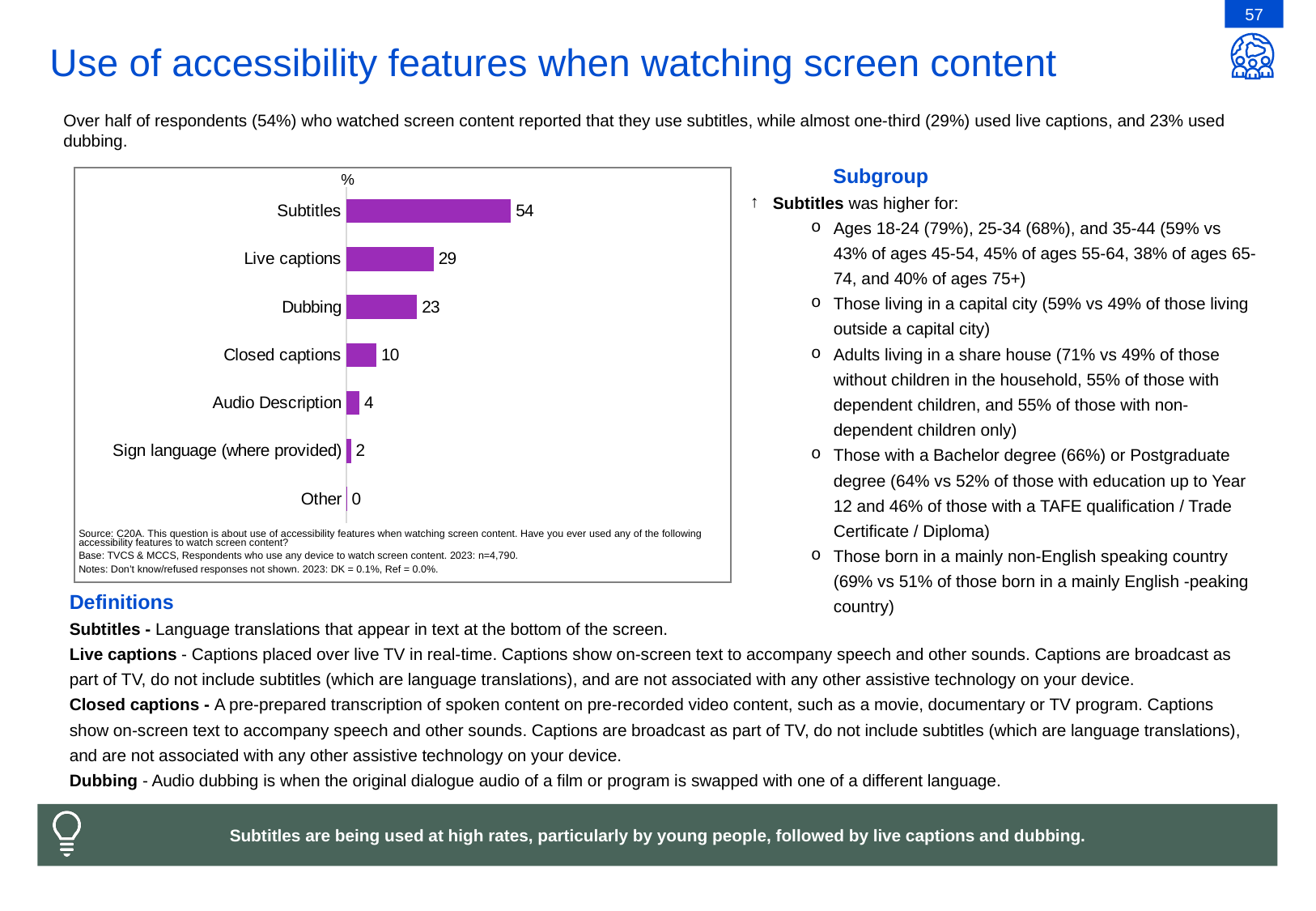
Which category has the highest value? Subtitles How many categories are shown in the chart? 7 What is the difference between the values for Subtitles and Live captions? 25 Which category has the lowest value? Other What is the difference between the values for Dubbing and Closed captions? 13 What kind of chart is shown on the slide? Bar chart Which is larger, the value for Dubbing or the value for Audio Description? Dubbing What is the value for Live captions? 29 What is the value for Closed captions? 10 What is the value for Subtitles? 54 What unit label is shown at the top of the chart's axis? % What is the value for Sign language (where provided)? 2